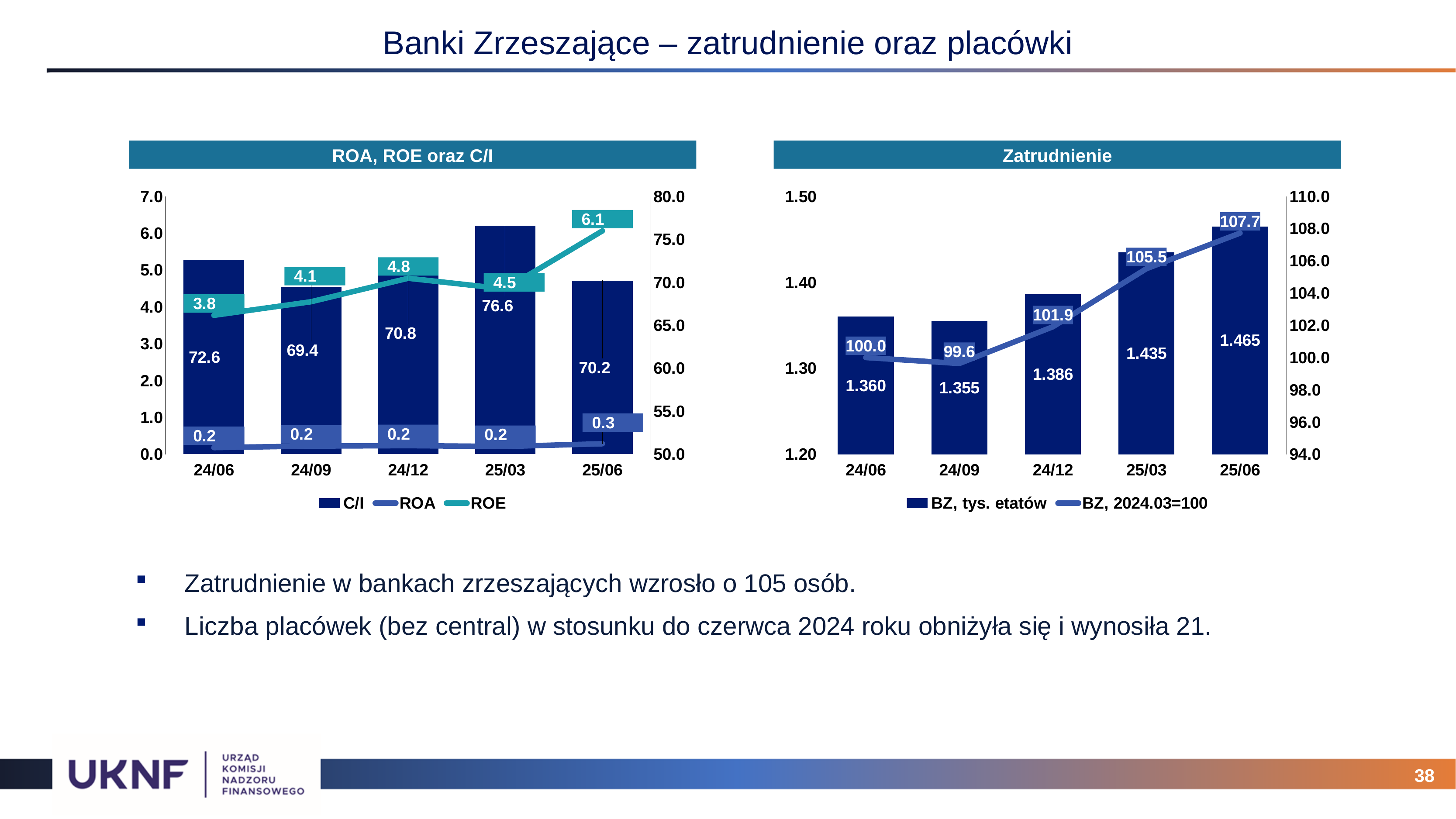
In the 'Zatrudnienie' chart, which period has the lowest 'BZ, tys. etatów' value? 24/09 In the 'Zatrudnienie' chart, how many periods are shown on the x axis? 5 In the 'ROA, ROE oraz C/I' chart, what is the ROE value for 25/06? 6.1 In the 'Zatrudnienie' chart, what is the value of 'BZ, tys. etatów' for 24/12? 1.386 In the 'ROA, ROE oraz C/I' chart, how many series does the legend list? 3 In the 'ROA, ROE oraz C/I' chart, which period has the lowest C/I value? 24/09 In the 'ROA, ROE oraz C/I' chart, which period has the highest ROE value? 25/06 In the 'ROA, ROE oraz C/I' chart, what is the C/I value for 25/03? 76.6 In the 'Zatrudnienie' chart, is the 'BZ, tys. etatów' value for 25/06 larger or smaller than for 24/06? larger In the 'Zatrudnienie' chart, does the 'BZ, 2024.03=100' line rise or fall from 24/09 to 25/06? rise In the 'Zatrudnienie' chart, what is the value of 'BZ, 2024.03=100' for 25/03? 105.5 In the 'ROA, ROE oraz C/I' chart, what is the difference between the C/I values for 25/03 and 24/09? 7.2